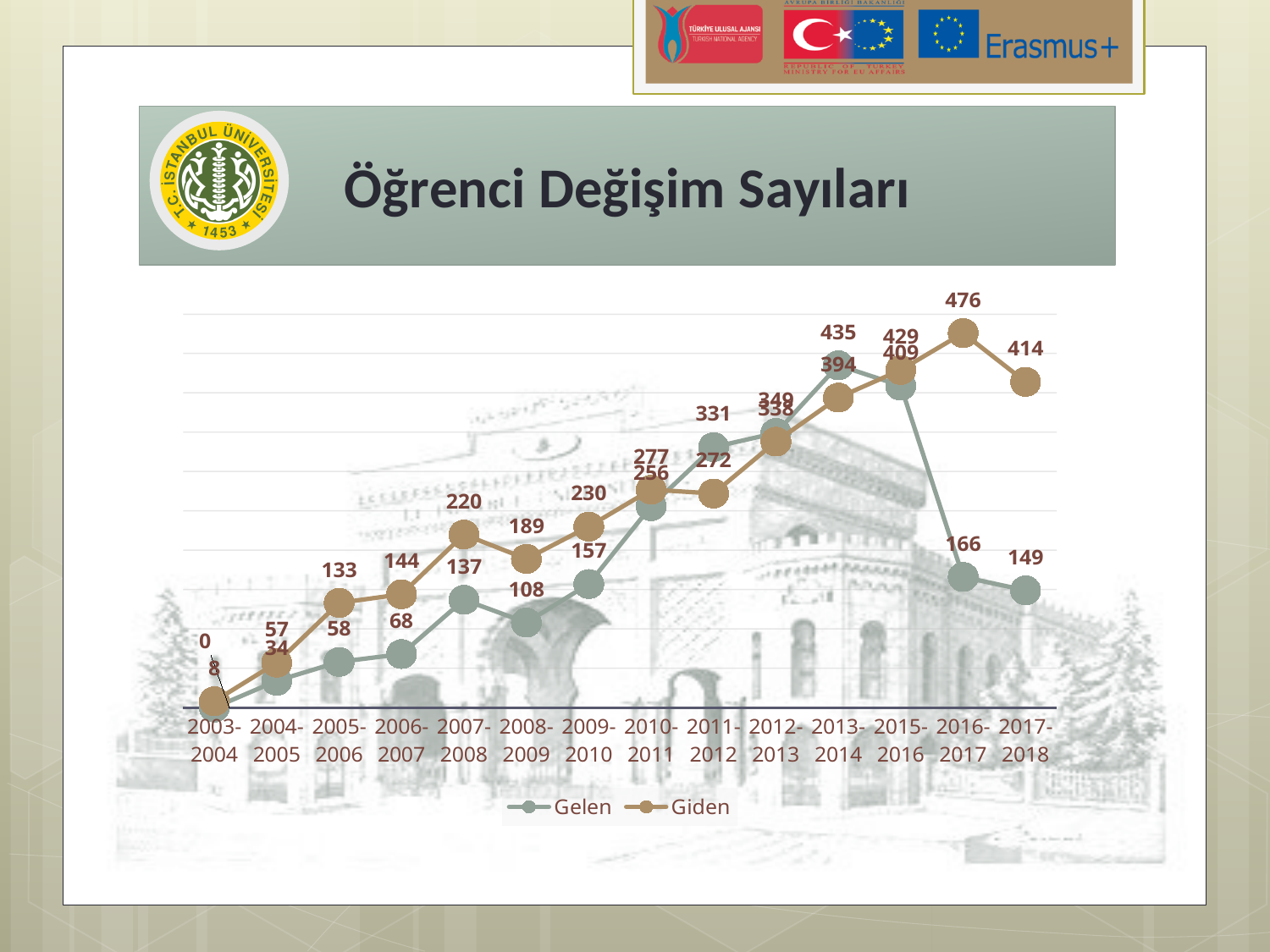
What are the two series named in the legend? Gelen and Giden What is the Gelen value for 2013-2014? 435 What is the Giden value for 2016-2017? 476 In which academic year does the Giden series reach its highest value? 2016-2017 What is the Gelen value for 2017-2018? 149 How many academic-year categories are shown on the x axis? 14 In 2007-2008, which series has the larger value, Gelen or Giden? Giden What is the difference between the Giden and Gelen values in 2016-2017? 310 What type of chart is shown on the slide? line chart What is the title of the slide containing the chart? Öğrenci Değişim Sayıları How many series does the legend list? 2 In which academic year is the Gelen series at its lowest value? 2003-2004